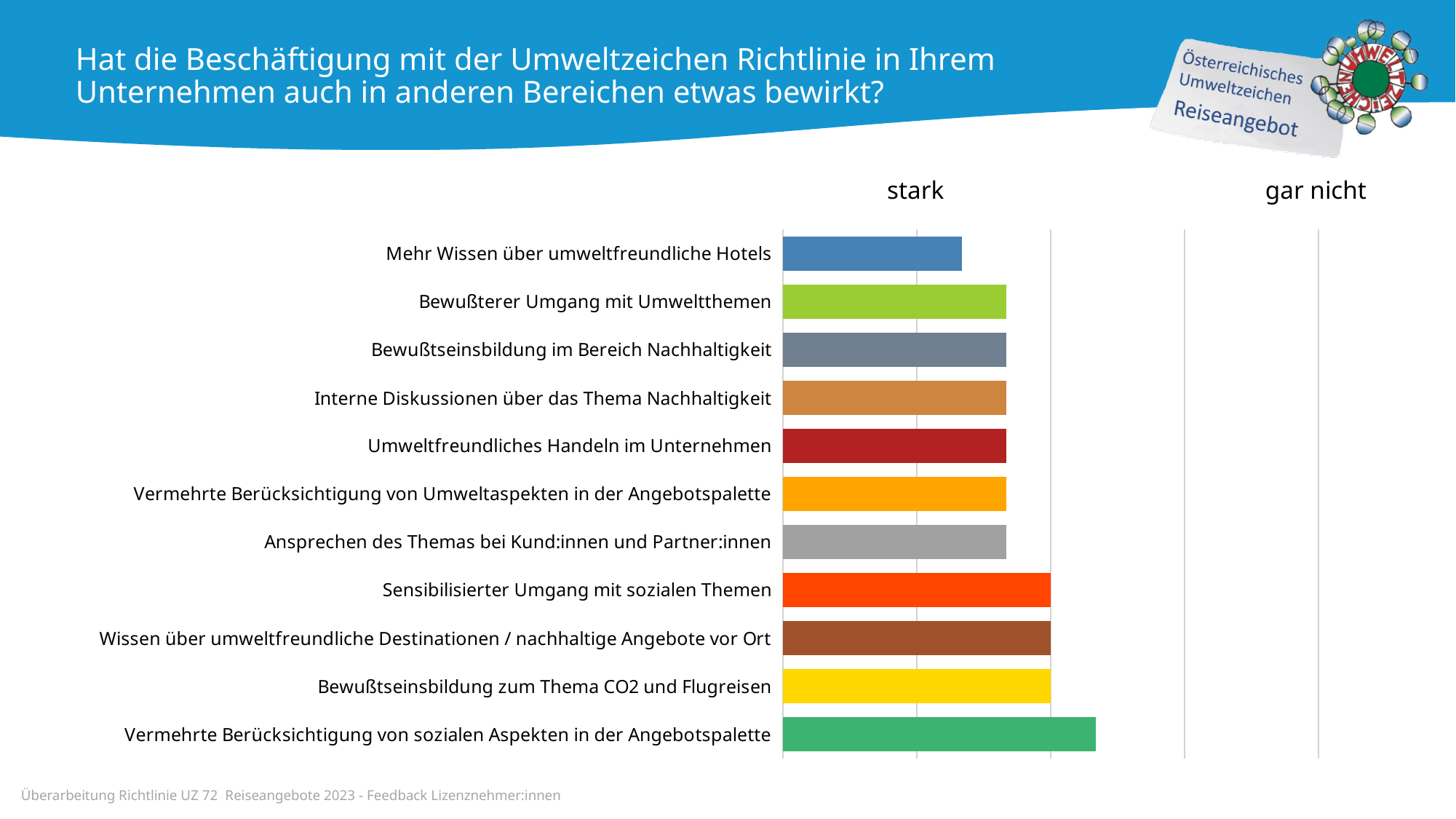
What kind of chart is shown on the slide? bar chart Which bar is longer: "Sensibilisierter Umgang mit sozialen Themen" or "Bewußterer Umgang mit Umweltthemen"? Sensibilisierter Umgang mit sozialen Themen Which category has the longest bar in the chart? Vermehrte Berücksichtigung von sozialen Aspekten in der Angebotspalette How many categories (bars) does the chart show? 11 Which category has the shortest bar in the chart? Mehr Wissen über umweltfreundliche Hotels What label appears at the left end of the chart's scale? stark Which bar is shorter: "Bewußtseinsbildung zum Thema CO2 und Flugreisen" or "Vermehrte Berücksichtigung von sozialen Aspekten in der Angebotspalette"? Bewußtseinsbildung zum Thema CO2 und Flugreisen Which bar is longer: "Mehr Wissen über umweltfreundliche Hotels" or "Umweltfreundliches Handeln im Unternehmen"? Umweltfreundliches Handeln im Unternehmen What label appears at the right end of the chart's scale? gar nicht